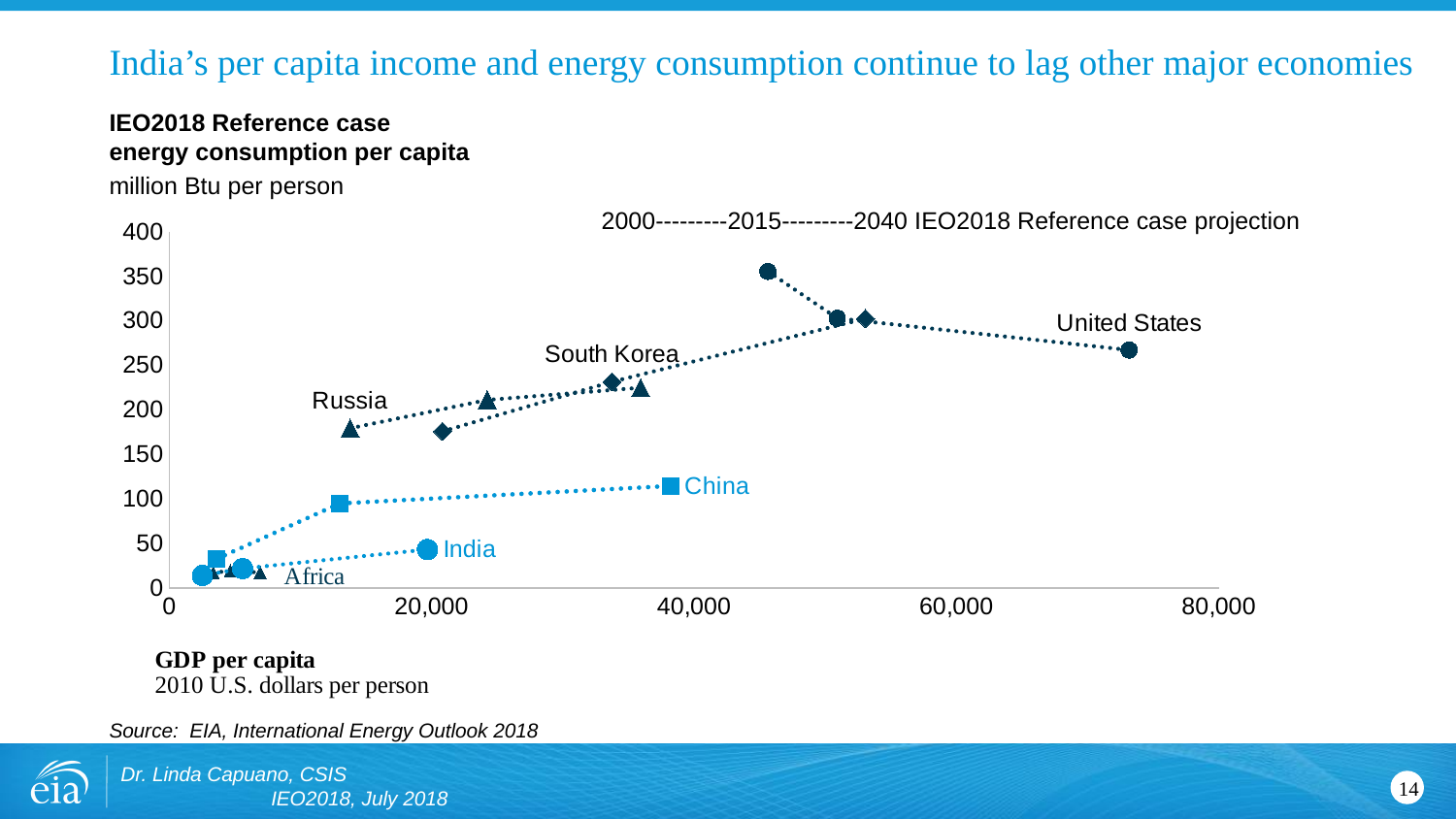
Is the 2040 energy consumption per capita for the United States greater or less than 300 million Btu per person? less What unit is used for the vertical axis of the chart? million Btu per person Is the 2040 GDP per capita for the United States greater or less than 60,000 dollars per person? greater Is the 2040 energy consumption per capita for China greater or less than 100 million Btu per person? greater Which economy has the highest energy consumption per capita in the 2040 projection? South Korea What kind of chart is shown on the slide? scatter chart Does the energy consumption per capita for the United States rise or fall from 2000 to 2040? fall Which has higher energy consumption per capita in 2040, China or India? China How many economies are plotted on the chart? 6 What unit is used for GDP per capita on the horizontal axis? 2010 U.S. dollars per person